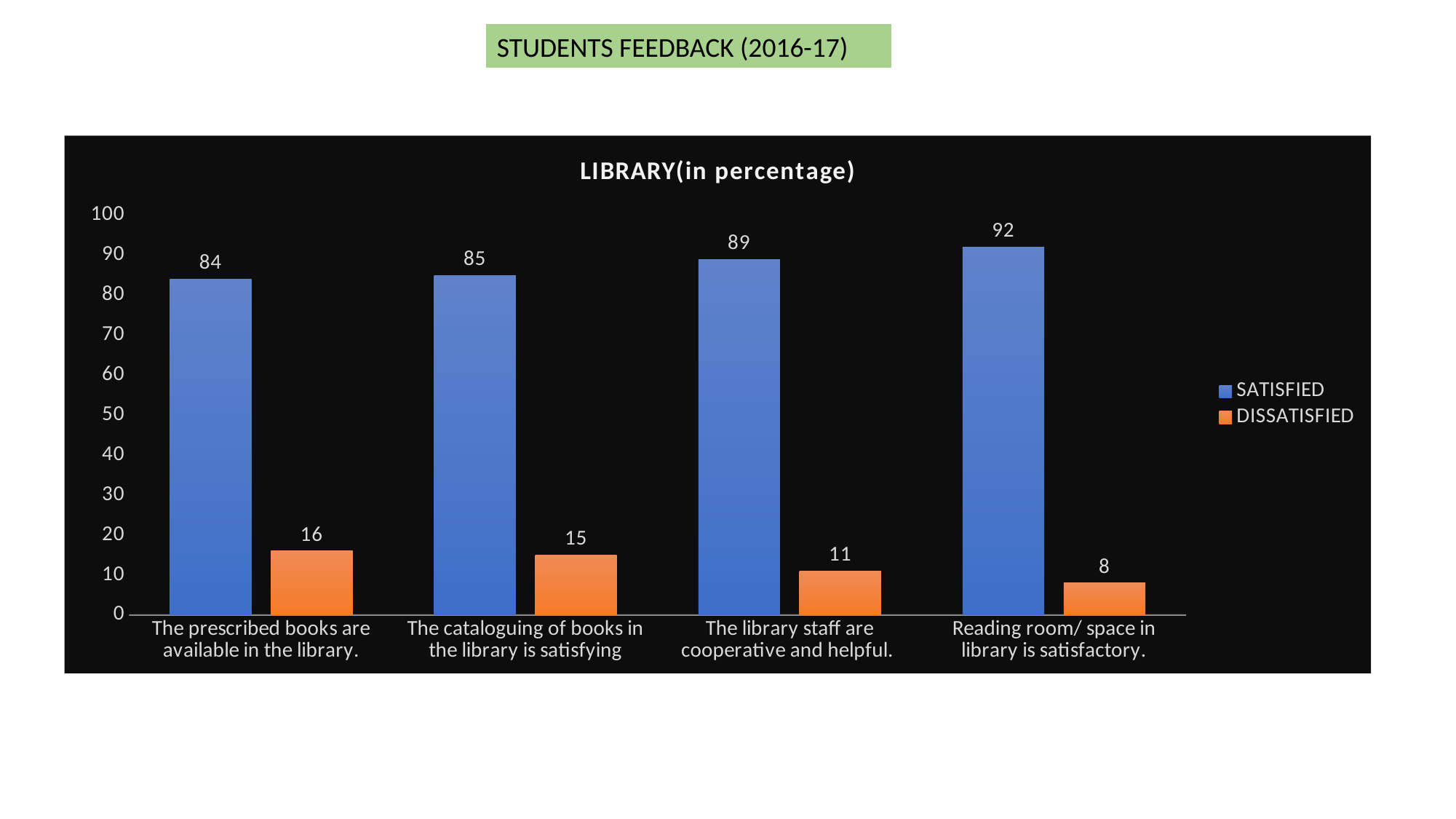
Which category has the highest SATISFIED value? Reading room/ space in library is satisfactory. What is the SATISFIED value for "Reading room/ space in library is satisfactory."? 92 What is the DISSATISFIED value for "The library staff are cooperative and helpful."? 11 Which is larger: the DISSATISFIED value for "The prescribed books are available in the library." or for "The library staff are cooperative and helpful."? The prescribed books are available in the library. Which category has the lowest DISSATISFIED value? Reading room/ space in library is satisfactory. How many categories are shown on the x axis? 4 What kind of chart is shown on the slide? bar chart What is the SATISFIED value for "The prescribed books are available in the library."? 84 Is the SATISFIED value for "The library staff are cooperative and helpful." greater or less than 80? greater What is the title of the chart? LIBRARY(in percentage) How many series does the legend list? 2 What is the difference between the SATISFIED and DISSATISFIED values for "The cataloguing of books in the library is satisfying"? 70